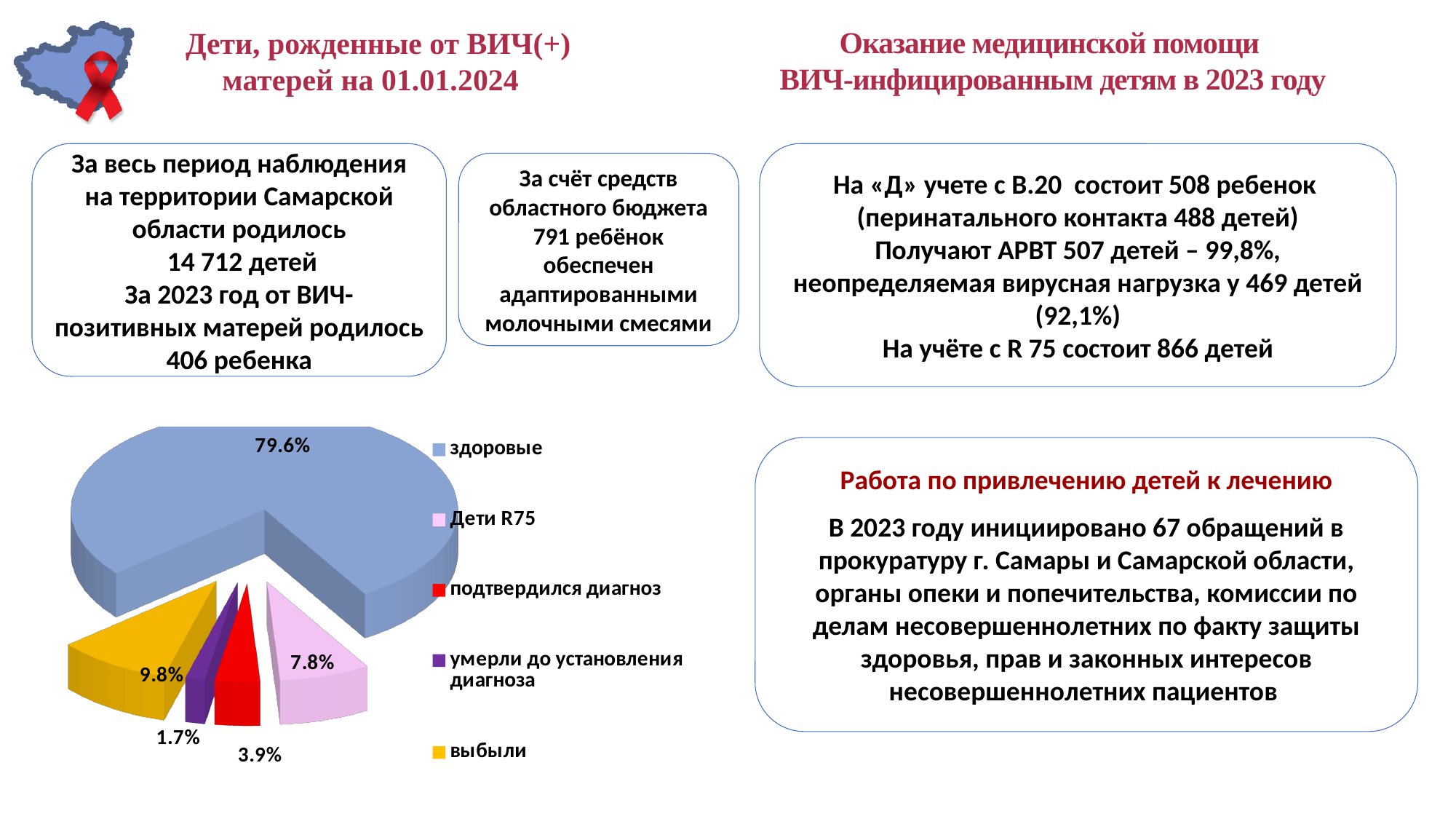
What is the difference between the "выбыли" share and the "подтвердился диагноз" share in the pie chart? 5.9% Which category has the smallest slice in the pie chart? умерли до установления диагноза How many slices does the pie chart have? 5 What kind of chart is shown on the slide? pie chart What share of the pie chart is labelled "здоровые"? 79.6% What share of the pie chart is labelled "выбыли"? 9.8% What share of the pie chart is labelled "умерли до установления диагноза"? 1.7% Which category has the largest slice in the pie chart? здоровые What colour is the "здоровые" slice in the pie chart? blue What share of the pie chart is labelled "подтвердился диагноз"? 3.9% Which is larger in the pie chart: "выбыли" or "Дети R75"? выбыли What share of the pie chart is labelled "Дети R75"? 7.8%